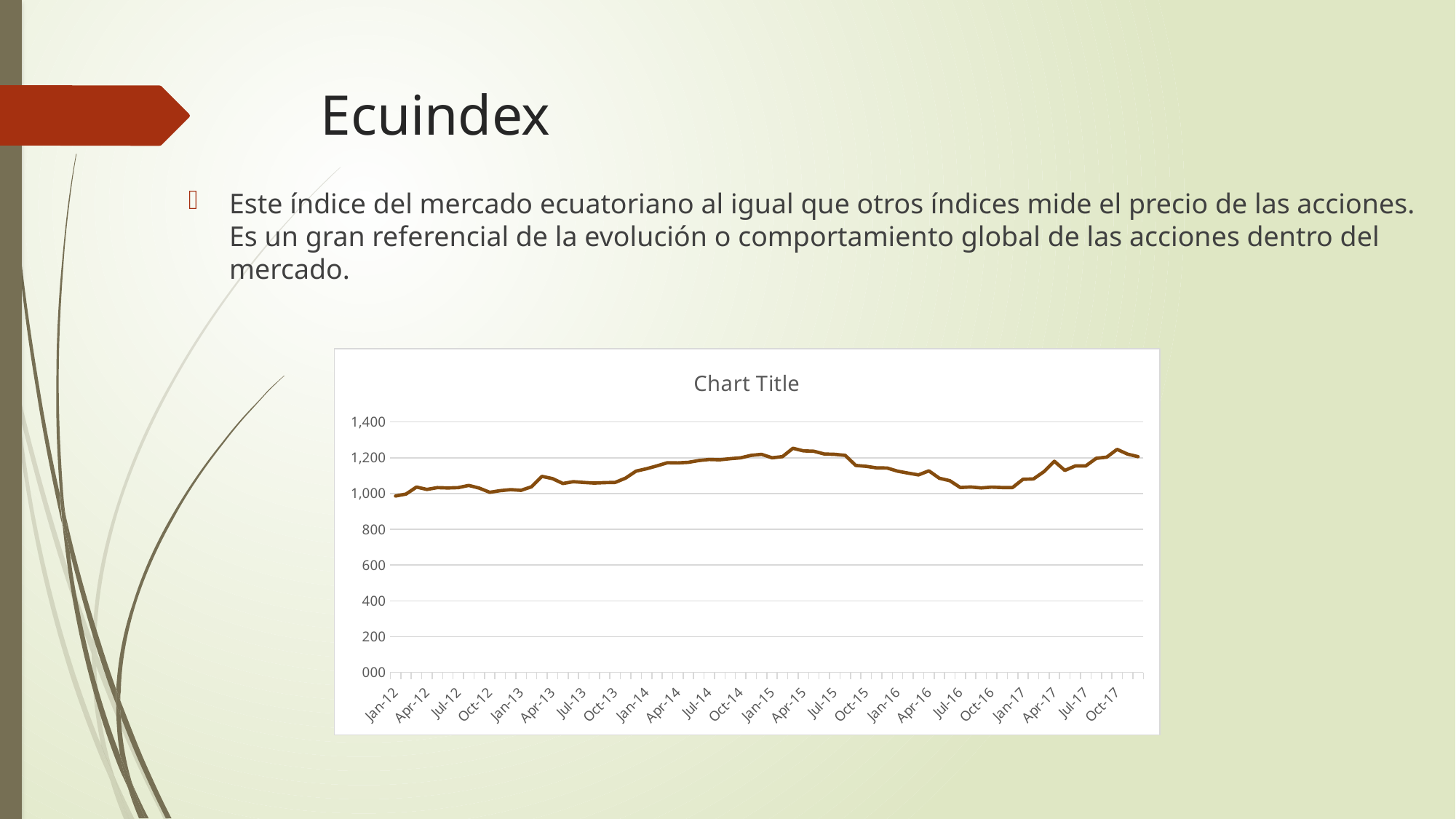
Is the value for Jan-14 greater or less than 1,000? greater What is the title of the chart? Chart Title Does the line ever fall below 800 on the chart? no Is the value for Oct-17 greater or less than 1,000? greater Does the line generally rise or fall between Jan-12 and Apr-15? rise What kind of chart is shown on the slide? line chart Which is larger, the value for Apr-15 or the value for Jul-16? Apr-15 What is the first label on the x axis of the chart? Jan-12 Does the line generally rise or fall between Apr-15 and Jul-16? fall